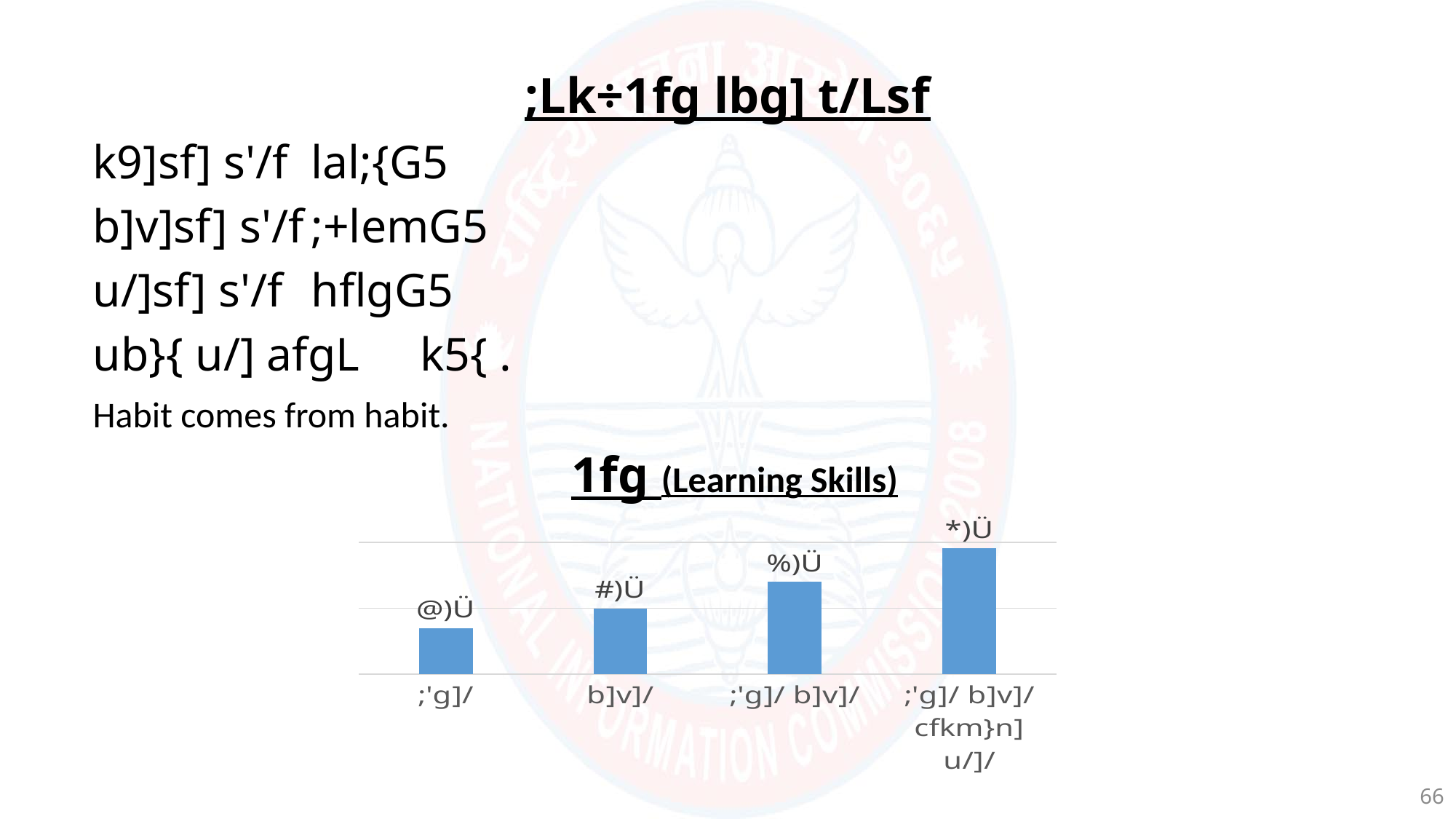
Which bar is taller: "b]v]/" or ";'g]/ b]v]/"? ;'g]/ b]v]/ How many bars does the chart show? 4 Do the bar values rise or fall from left to right across the chart? rise What colour are the bars in the chart? blue What kind of chart is shown on the slide? bar chart What is the data label printed above the bar for ";'g]/ b]v]/"? %)Ü Which category has the shortest bar in the chart? ;'g]/ What is the English text in parentheses in the chart title? Learning Skills What is the data label printed above the rightmost bar? *)Ü What is the data label printed above the bar for ";'g]/"? @)Ü What is the data label printed above the bar for "b]v]/"? #)Ü Which category has the tallest bar in the chart? ;'g]/ b]v]/ cfkm}n] u/]/